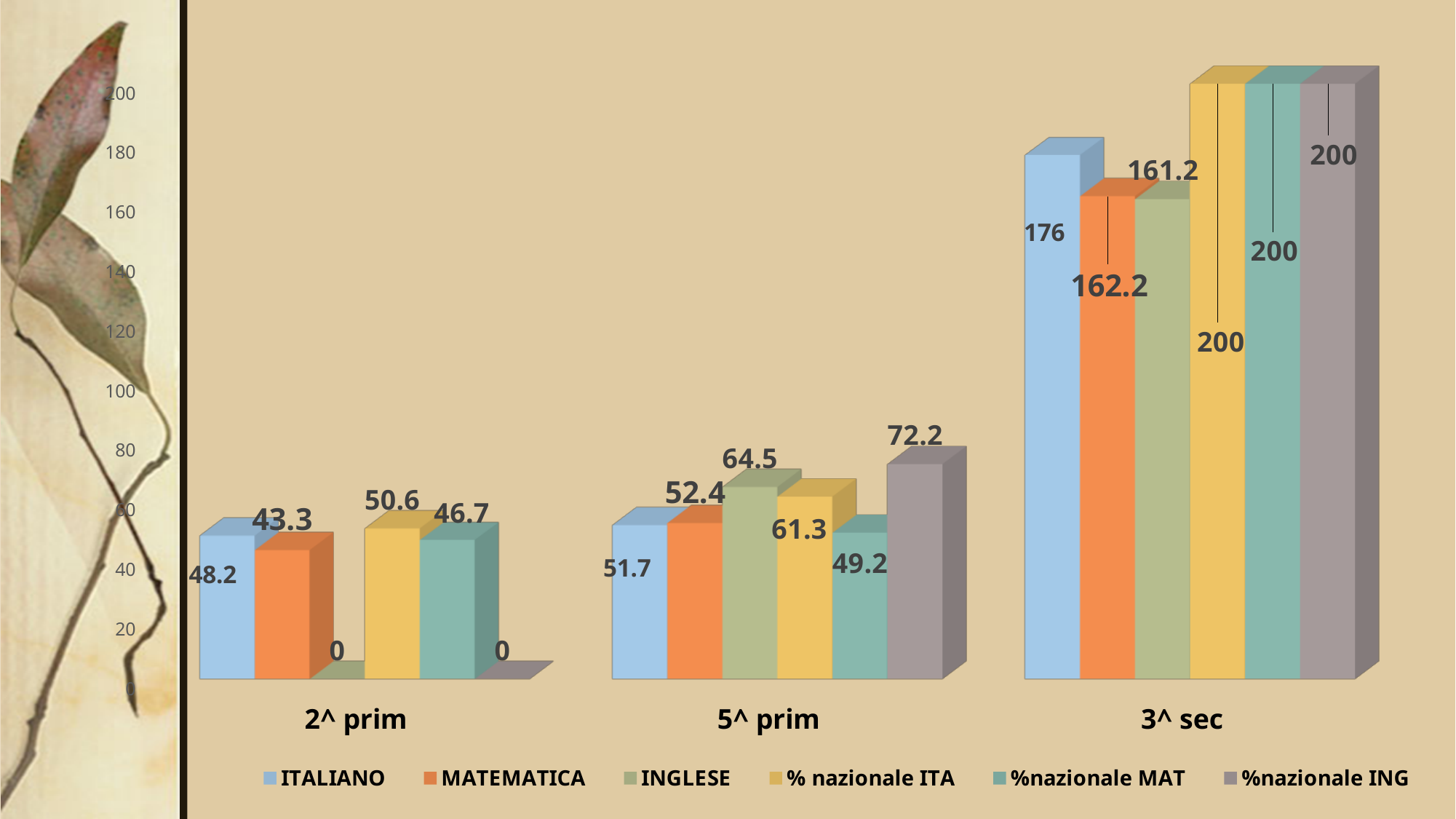
How many series does the legend list? 6 Is the value for INGLESE in the 3^ sec category greater or less than 140? greater What is the value for % nazionale ITA in the 5^ prim category? 61.3 How many categories are shown on the x axis? 3 What is the difference between the ITALIANO and MATEMATICA values in the 3^ sec category? 13.8 What is the value for MATEMATICA in the 3^ sec category? 162.2 Which series has the highest value in the 5^ prim category? %nazionale ING What kind of chart is shown on the slide? Bar chart Which is larger in the 2^ prim category, ITALIANO or MATEMATICA? ITALIANO What is the value for ITALIANO in the 2^ prim category? 48.2 Which series has the lowest value in the 5^ prim category? %nazionale MAT What is the value for %nazionale ING in the 5^ prim category? 72.2